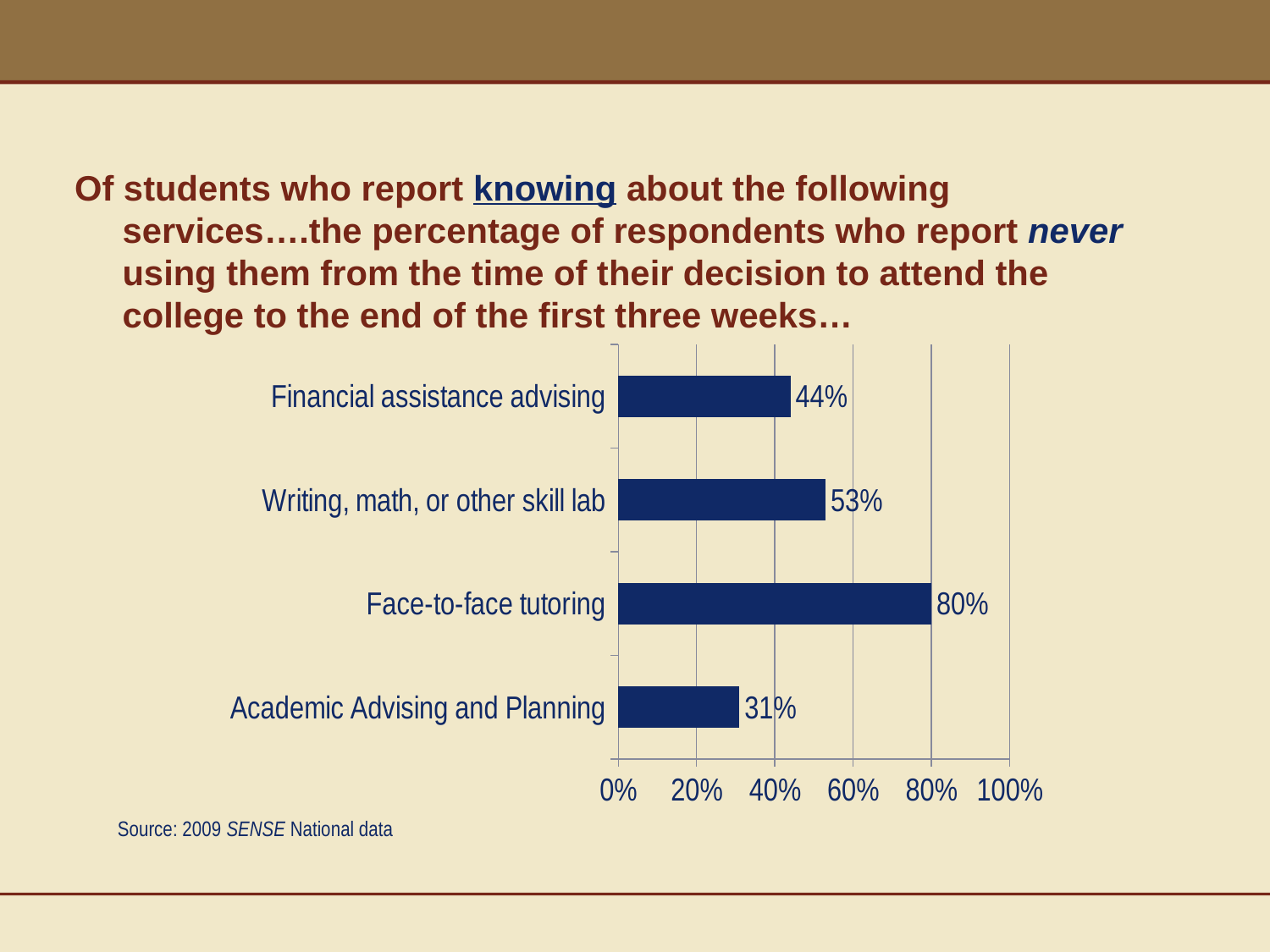
What is the value shown for Academic Advising and Planning? 31% What kind of chart is shown on the slide? Bar chart What is the value shown for Face-to-face tutoring? 80% What is the value shown for Writing, math, or other skill lab? 53% What is the difference between the values for Face-to-face tutoring and Academic Advising and Planning? 49% What percentage of respondents report never using Financial assistance advising? 44% What is the source cited below the chart? 2009 SENSE National data What is the difference between the values for Writing, math, or other skill lab and Financial assistance advising? 9% Which service has the lowest percentage of respondents who report never using it? Academic Advising and Planning Which is larger: the value for Writing, math, or other skill lab or the value for Financial assistance advising? Writing, math, or other skill lab Which service has the highest percentage of respondents who report never using it? Face-to-face tutoring How many services are shown in the chart? 4